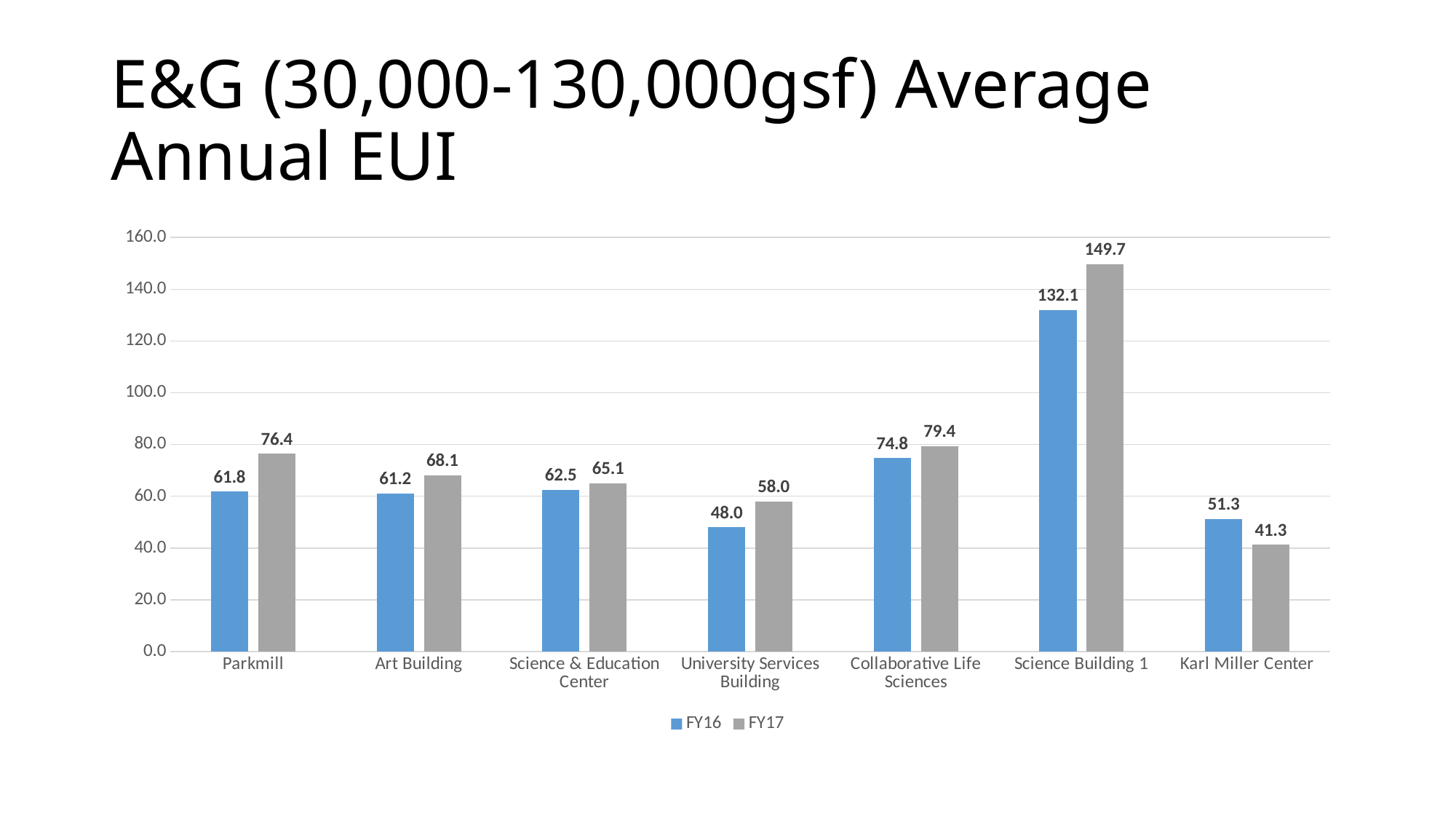
Is the FY17 value for Collaborative Life Sciences greater or less than 60.0? greater Which building has the highest FY17 value? Science Building 1 What kind of chart is shown on the slide? Bar chart How many series does the legend list? 2 What is the difference between the FY17 and FY16 values for Science Building 1? 17.6 What is the FY16 value for University Services Building? 48.0 Which building has the lowest FY16 value? University Services Building What is the FY17 value for Science Building 1? 149.7 What colour are the FY17 bars? Grey How many buildings are shown on the x axis? 7 What is the FY16 value for Parkmill? 61.8 Which is larger for Karl Miller Center, the FY16 value or the FY17 value? FY16